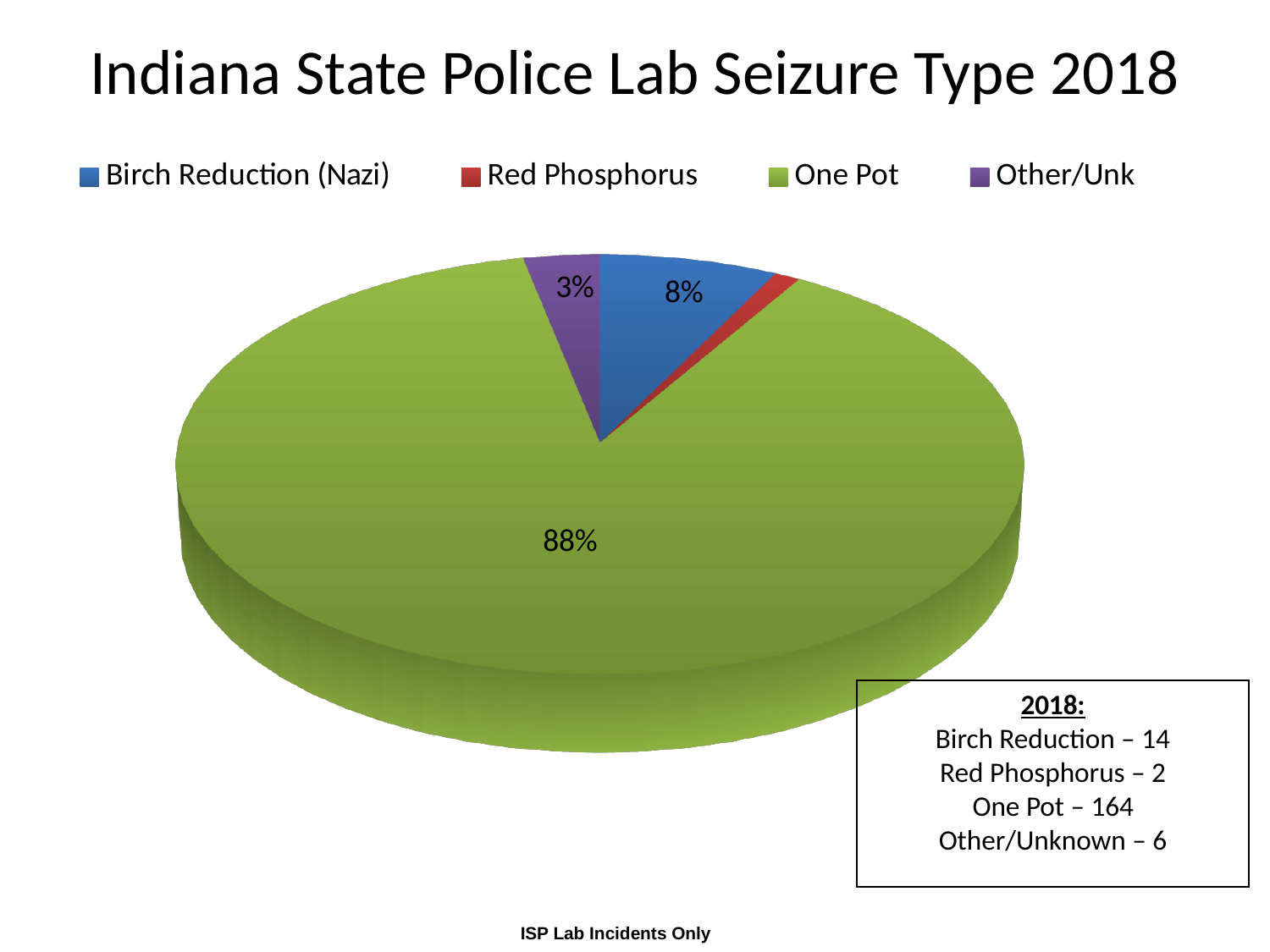
According to the text box on the slide, how many One Pot lab seizures were there in 2018? 164 What kind of chart is shown on the slide? pie chart What share of the pie does Other/Unk account for? 3% What share of the pie does Birch Reduction (Nazi) account for? 8% How many seizure types does the legend list? 4 How many percentage points larger is the One Pot share than the Birch Reduction (Nazi) share? 80 Which seizure type has the smallest slice of the pie? Red Phosphorus What share of the pie does One Pot account for? 88% Which seizure type has the largest slice of the pie? One Pot Which slice is larger, Birch Reduction (Nazi) or Other/Unk? Birch Reduction (Nazi) What is the title of the chart? Indiana State Police Lab Seizure Type 2018 According to the text box on the slide, how many Red Phosphorus lab seizures were there in 2018? 2